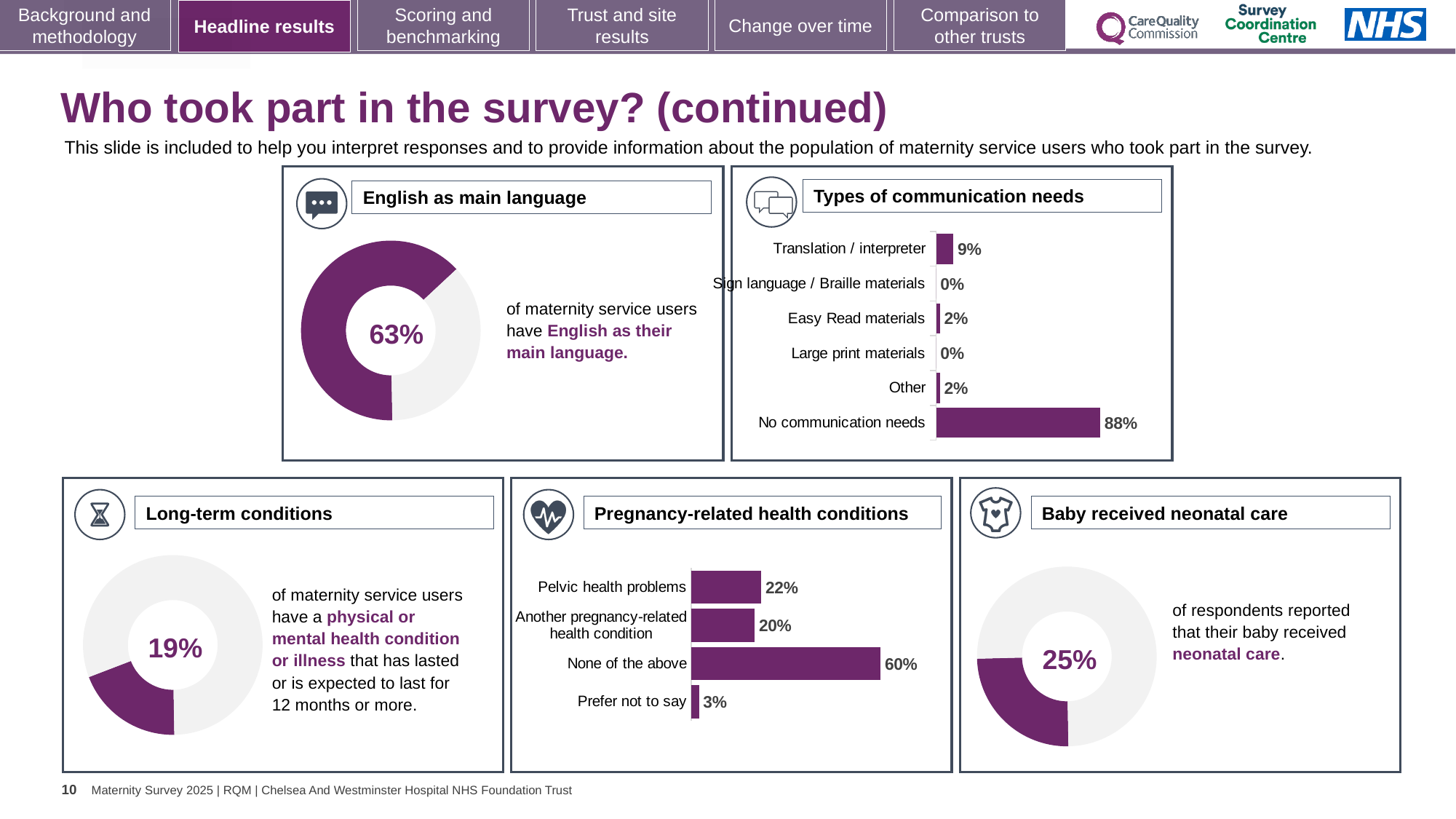
In the 'Types of communication needs' chart, what is the value for Translation / interpreter? 9% In the 'Baby received neonatal care' chart, what percentage of respondents reported that their baby received neonatal care? 25% In the 'Long-term conditions' chart, what percentage of maternity service users have a long-term physical or mental health condition? 19% In the 'English as main language' chart, what percentage of maternity service users have English as their main language? 63% In the 'Pregnancy-related health conditions' chart, what is the value for Pelvic health problems? 22% In the 'Types of communication needs' chart, which category has the highest value? No communication needs In the 'Pregnancy-related health conditions' chart, which category has the lowest value? Prefer not to say In the 'Pregnancy-related health conditions' chart, which is larger: Pelvic health problems or Another pregnancy-related health condition? Pelvic health problems In the 'Pregnancy-related health conditions' chart, what is the difference between None of the above and Pelvic health problems? 38% In the 'Types of communication needs' chart, what is the difference between No communication needs and Translation / interpreter? 79% What kind of chart is the 'Types of communication needs' chart? Bar chart In the 'Types of communication needs' chart, how many categories are shown? 6